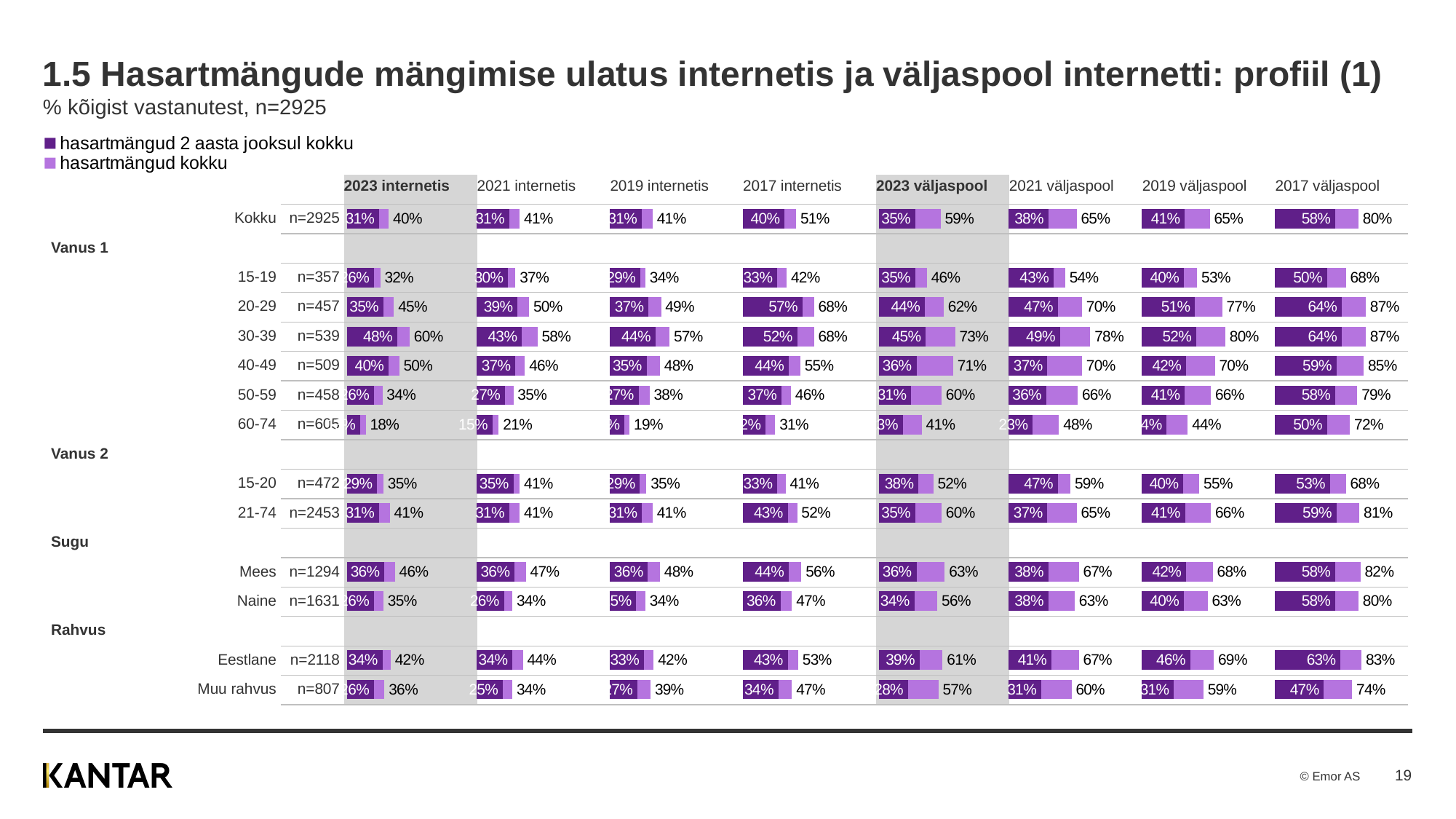
What kind of chart is used on this slide? bar chart How many series does the legend list? 2 In the 2023 internetis column, which Vanus 1 age group has the highest 'hasartmängud kokku' value? 30-39 In the 2017 väljaspool column, what is the difference in 'hasartmängud kokku' between Eestlane and Muu rahvus? 9 percentage points In the 2017 väljaspool column, what is the 'hasartmängud kokku' value for the Kokku row? 80% For the Kokku row, is the 'hasartmängud kokku' value for 2023 väljaspool higher or lower than for 2017 väljaspool? lower In the 2017 internetis column, what is the 'hasartmängud 2 aasta jooksul kokku' value for the 20-29 age group? 57% How many year/channel columns (e.g. 2023 internetis, 2021 väljaspool) does the chart show? 8 In the 2023 internetis column, what is the 'hasartmängud kokku' value for the Kokku row? 40% In the 2023 internetis column, which has the higher 'hasartmängud kokku' value, Mees or Naine? Mees In the 2017 väljaspool column, which Vanus 1 age group has the lowest 'hasartmängud kokku' value? 15-19 In the 2023 internetis column, what is the 'hasartmängud 2 aasta jooksul kokku' value for the 30-39 age group? 48%